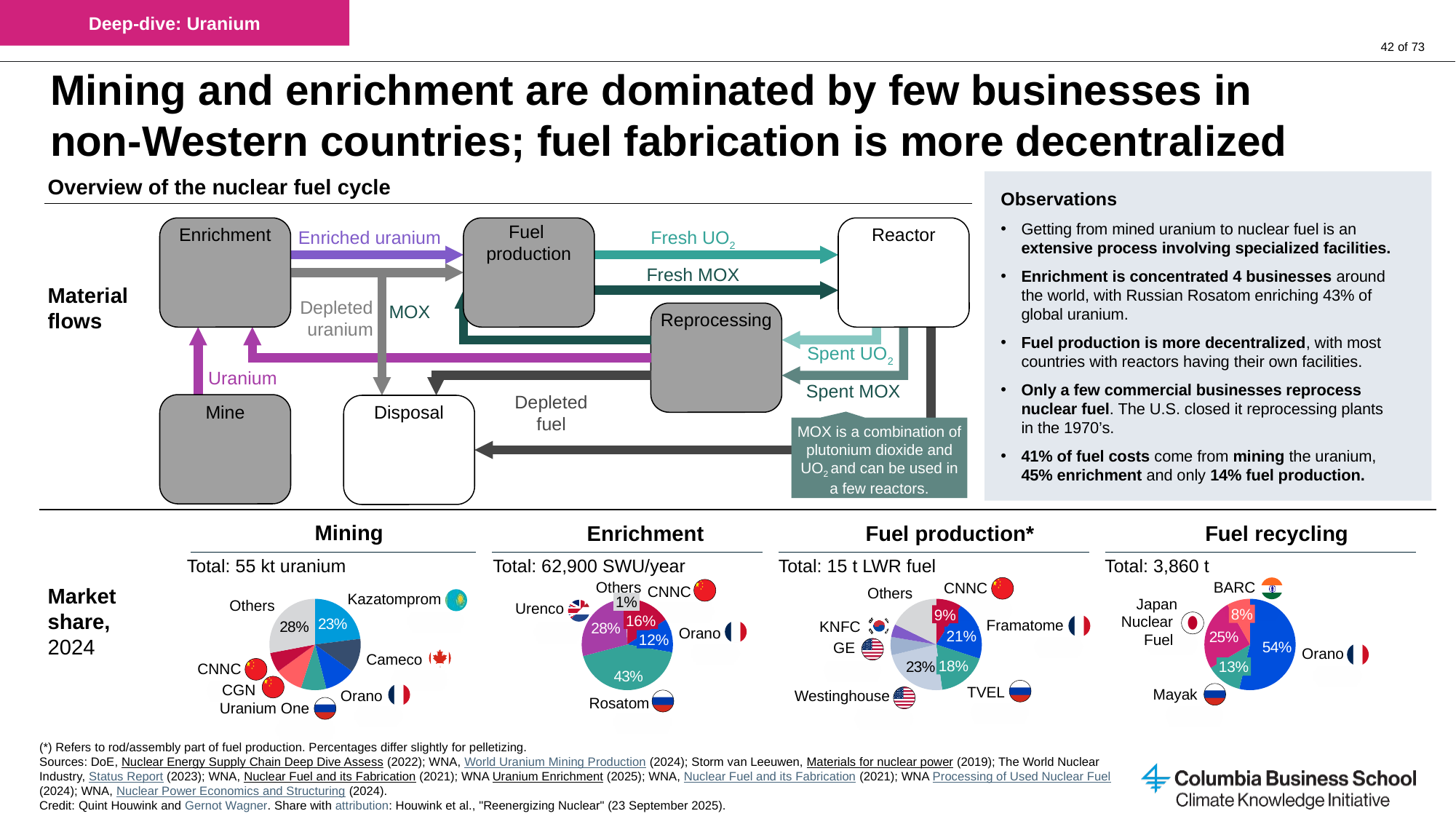
In the Mining pie chart, what market share does Kazatomprom hold? 23% In the Fuel recycling pie chart, what market share does Orano hold? 54% In the Fuel production* pie chart, what market share does Westinghouse hold? 23% In the Enrichment pie chart, what market share does Rosatom hold? 43% In the Fuel production* pie chart, which is larger, Framatome's share or TVEL's share? Framatome In the Enrichment pie chart, what market share does Urenco hold? 28% In the Fuel recycling pie chart, how many slices are shown? 4 In the Enrichment pie chart, what is the difference in market share between Rosatom and Orano? 31 percentage points What kind of chart is used to show market share for Mining? Pie chart In the Enrichment pie chart, which company has the largest market share? Rosatom What total is stated above the Enrichment pie chart? 62,900 SWU/year In the Fuel recycling pie chart, which company has the smallest market share? BARC